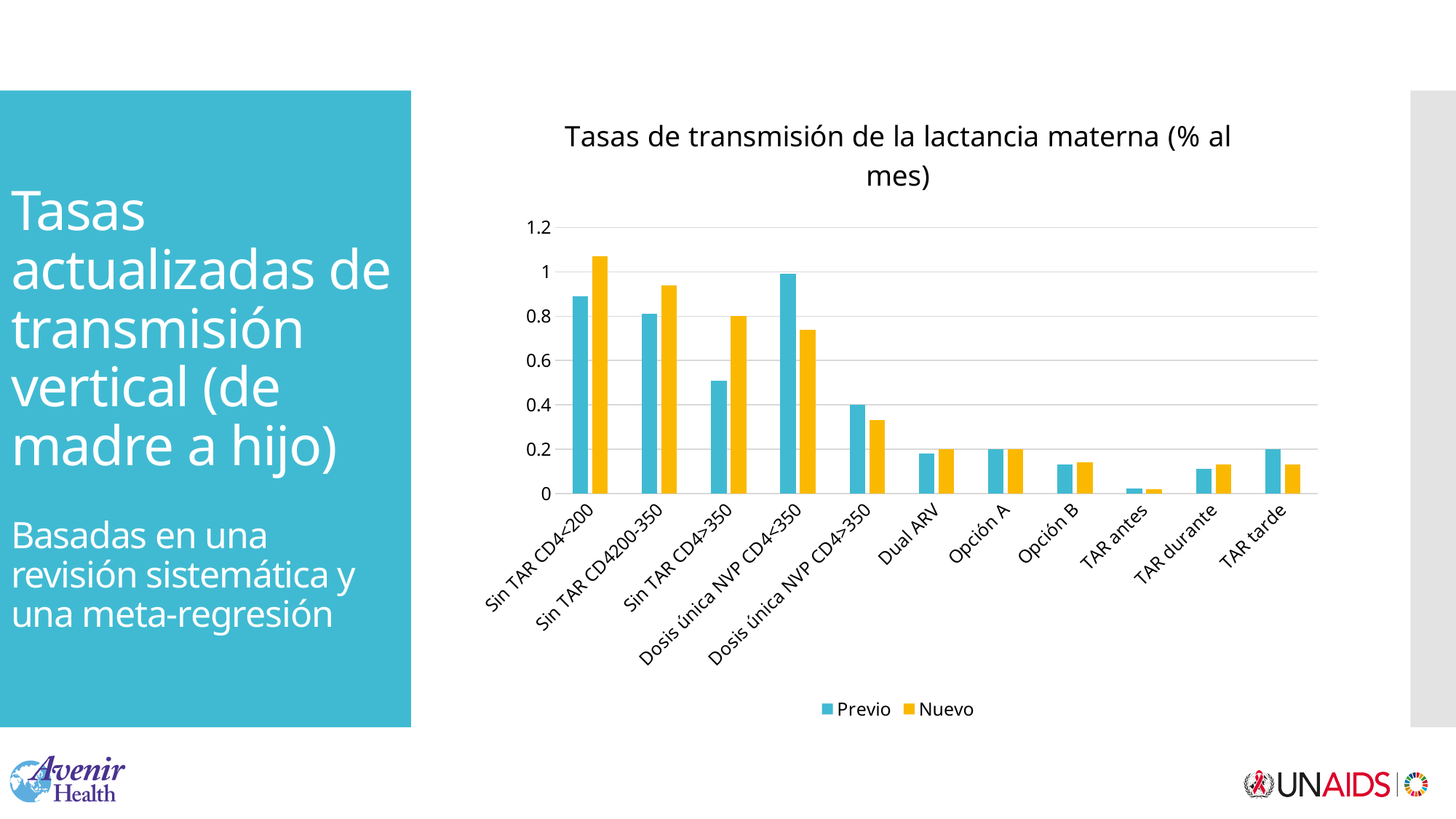
What kind of chart is shown on the slide? Bar chart Is the Nuevo value for Sin TAR CD4<200 greater or less than 1? greater Which category has the highest Nuevo value? Sin TAR CD4<200 Is the Previo value for Sin TAR CD4>350 greater or less than 0.6? less How many series does the legend list? 2 For Dosis única NVP CD4<350, which is larger, Previo or Nuevo? Previo Which category has the highest Previo value? Dosis única NVP CD4<350 Which colour represents the Nuevo series in the legend? Yellow What is the title of the chart? Tasas de transmisión de la lactancia materna (% al mes) How many categories are shown on the x axis? 11 Which category has the lowest Nuevo value? TAR antes For Sin TAR CD4>350, which is larger, Previo or Nuevo? Nuevo